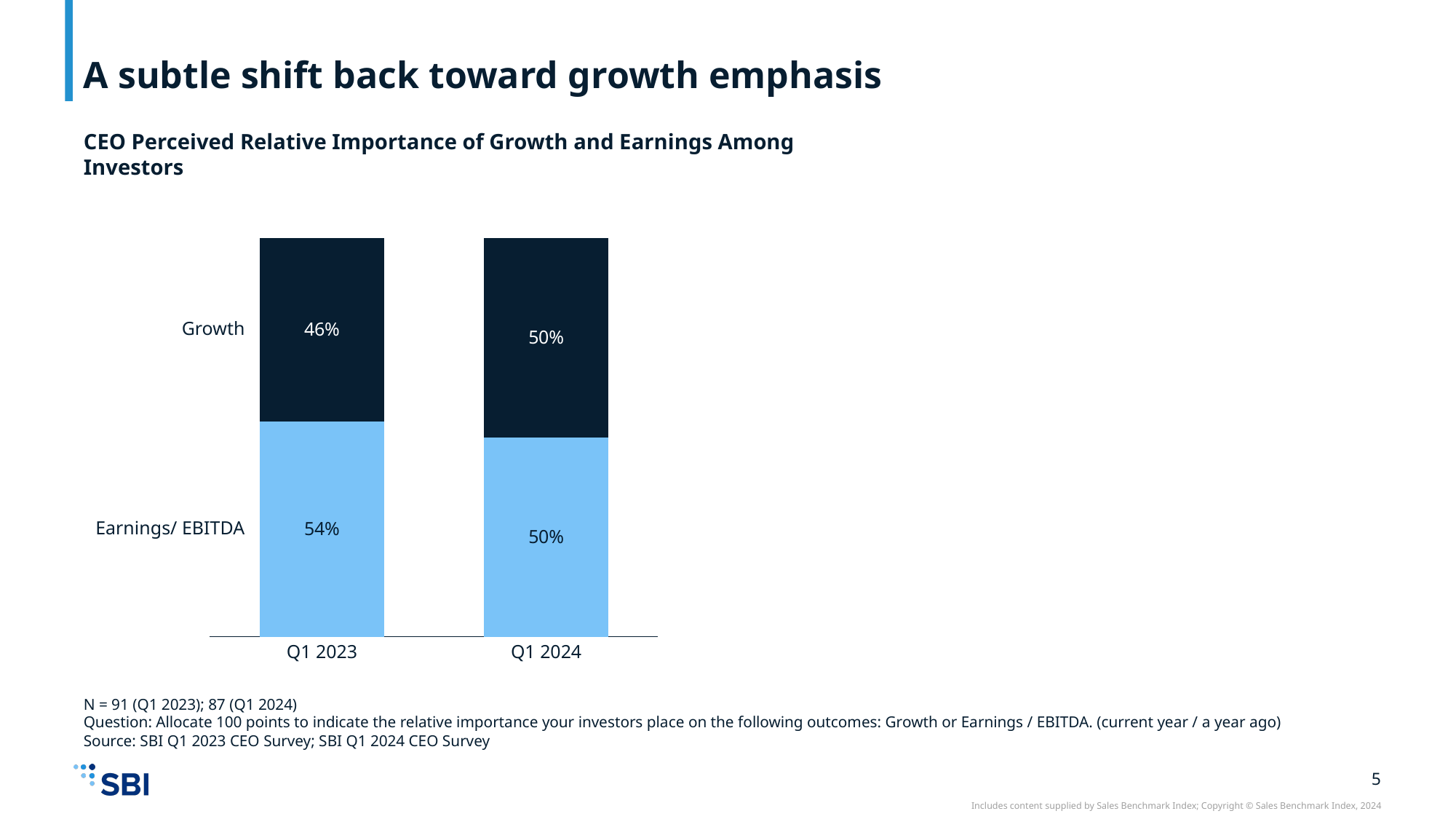
What is the total of the stacked bar for Q1 2024? 100% What is the difference between the Earnings/ EBITDA and Growth shares in Q1 2023? 8 percentage points What is the Earnings/ EBITDA value for Q1 2024? 50% What is the Growth value for Q1 2023? 46% What is the title of the chart? CEO Perceived Relative Importance of Growth and Earnings Among Investors What kind of chart is shown on the slide? Stacked bar chart What is the Earnings/ EBITDA value for Q1 2023? 54% What is the Growth value for Q1 2024? 50% In which quarter is the Growth share higher? Q1 2024 By how many percentage points did the Growth share change from Q1 2023 to Q1 2024? 4 percentage points How many quarters are shown on the x axis? 2 In which quarter is the Earnings/ EBITDA share higher? Q1 2023